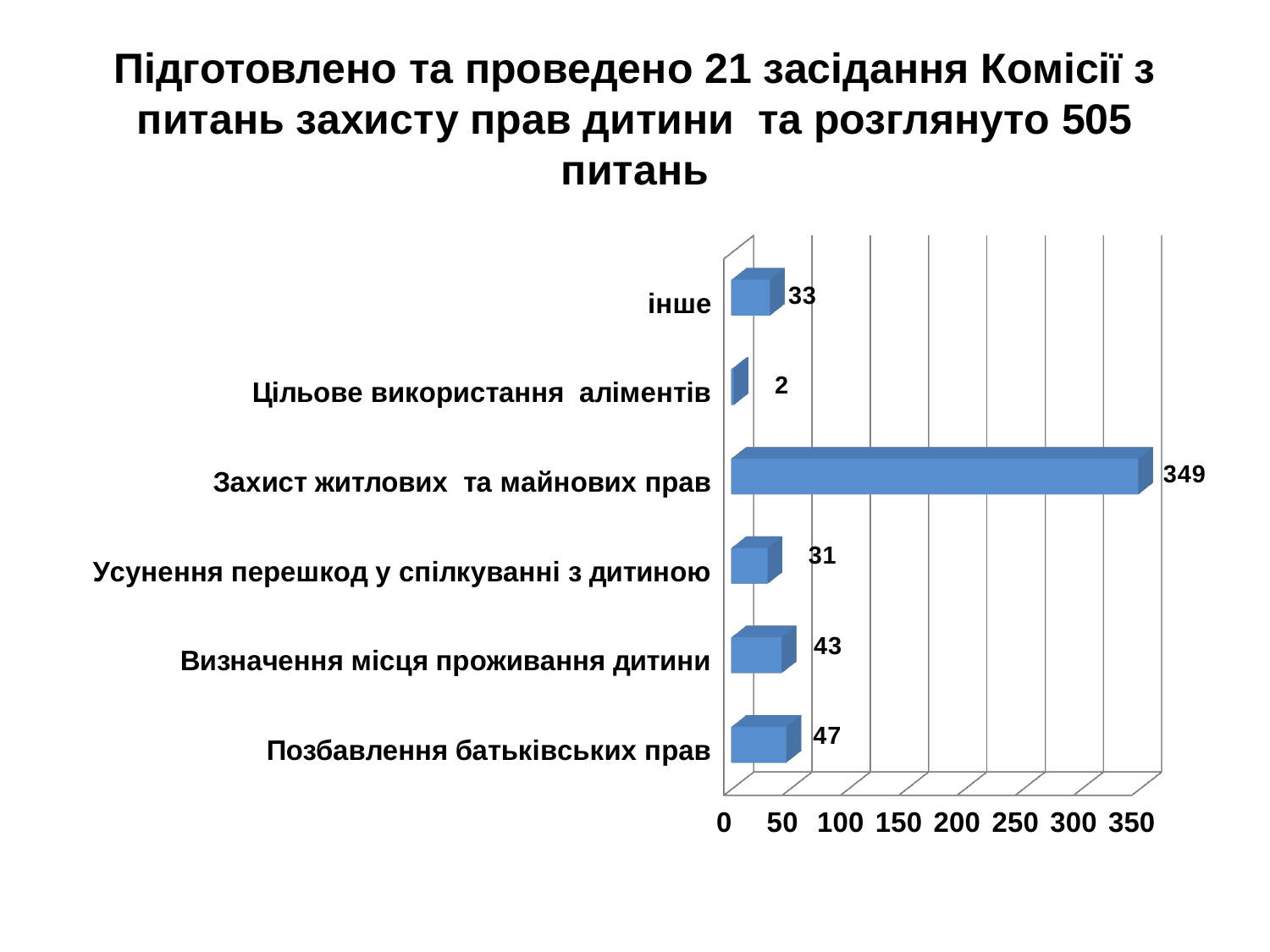
Which category has the lowest value? Цільове використання аліментів Is the value for "Захист житлових та майнових прав" greater or less than 300? greater What is the value for "Позбавлення батьківських прав"? 47 What is the value for "Захист житлових та майнових прав"? 349 Which category has the highest value? Захист житлових та майнових прав What is the difference between the values for "Позбавлення батьківських прав" and "Визначення місця проживання дитини"? 4 Which is larger: the value for "інше" or the value for "Усунення перешкод у спілкуванні з дитиною"? інше How many categories are shown in the chart? 6 What kind of chart is shown on the slide? bar chart What is the value for "інше"? 33 What is the value for "Цільове використання аліментів"? 2 What is the value for "Визначення місця проживання дитини"? 43